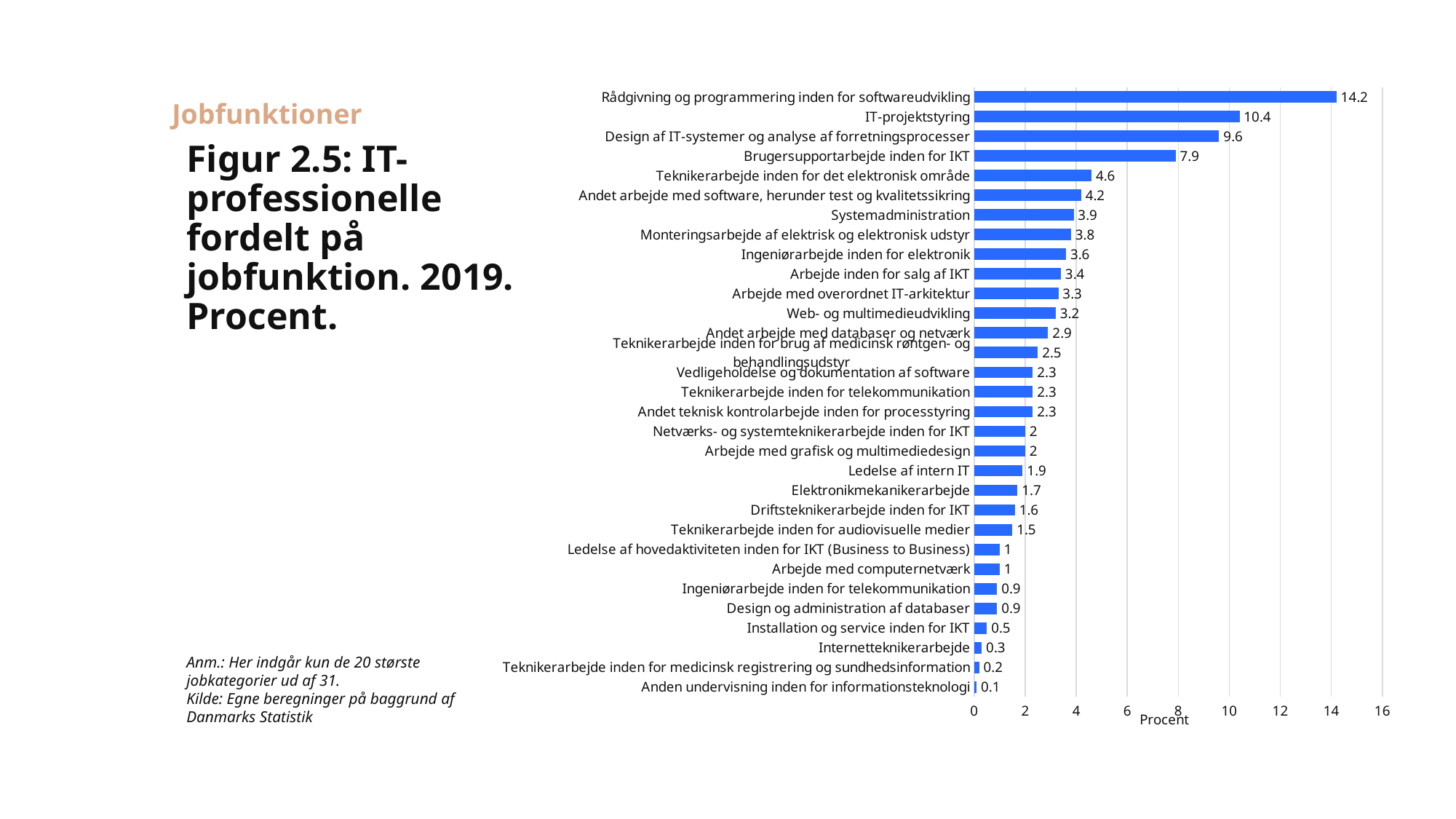
What is the value for Systemadministration? 3.9 What is the difference between the values for Rådgivning og programmering inden for softwareudvikling and IT-projektstyring? 3.8 What is the label of the horizontal axis? Procent Is the value for Rådgivning og programmering inden for softwareudvikling greater or less than 12? greater What is the value for Web- og multimedieudvikling? 3.2 What kind of chart is shown on the slide? bar chart What is the difference between the values for Brugersupportarbejde inden for IKT and Teknikerarbejde inden for det elektronisk område? 3.3 Which job function has the lowest value? Anden undervisning inden for informationsteknologi How many job functions are shown in the chart? 31 What is the value for IT-projektstyring? 10.4 Which job function has the highest value? Rådgivning og programmering inden for softwareudvikling Which is larger: the value for Design af IT-systemer og analyse af forretningsprocesser or the value for Brugersupportarbejde inden for IKT? Design af IT-systemer og analyse af forretningsprocesser